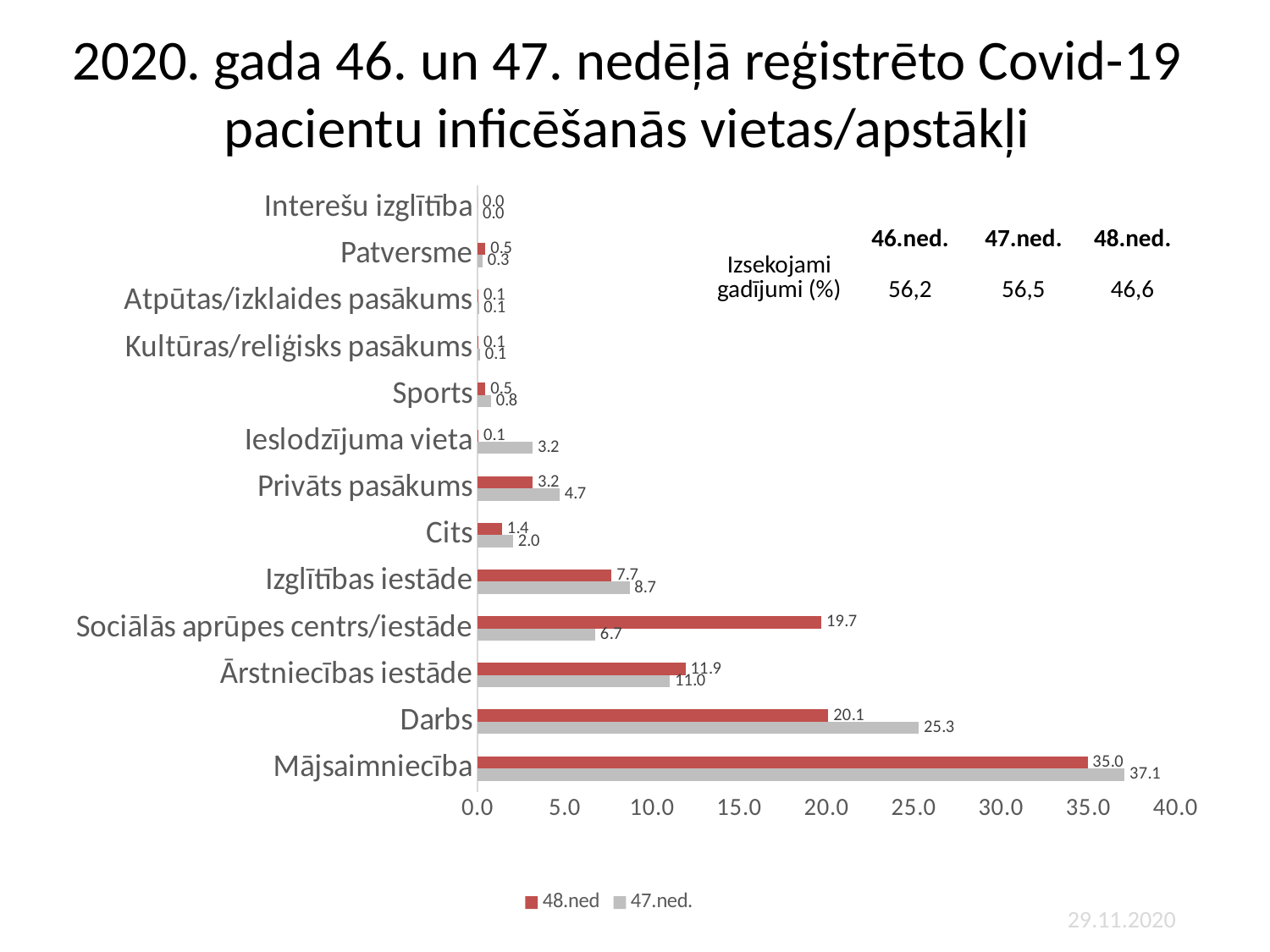
What is the value for Sociālās aprūpes centrs/iestāde in the 48.ned series? 19.7 What is the difference between the 47.ned. and 48.ned values for Darbs? 5.2 What is the value for Darbs in the 47.ned. series? 25.3 Which category has the highest value in the 47.ned. series? Mājsaimniecība Which is larger for Sociālās aprūpes centrs/iestāde: the 48.ned value or the 47.ned. value? 48.ned Is the 47.ned. value for Mājsaimniecība greater or less than 35.0? greater What kind of chart is shown on the slide? bar chart Which colour represents the 48.ned series in the legend? red How many series does the legend list? 2 What is the difference between the 47.ned. and 48.ned values for Ieslodzījuma vieta? 3.1 What is the value for Mājsaimniecība in the 48.ned series? 35.0 How many categories are shown on the chart? 13